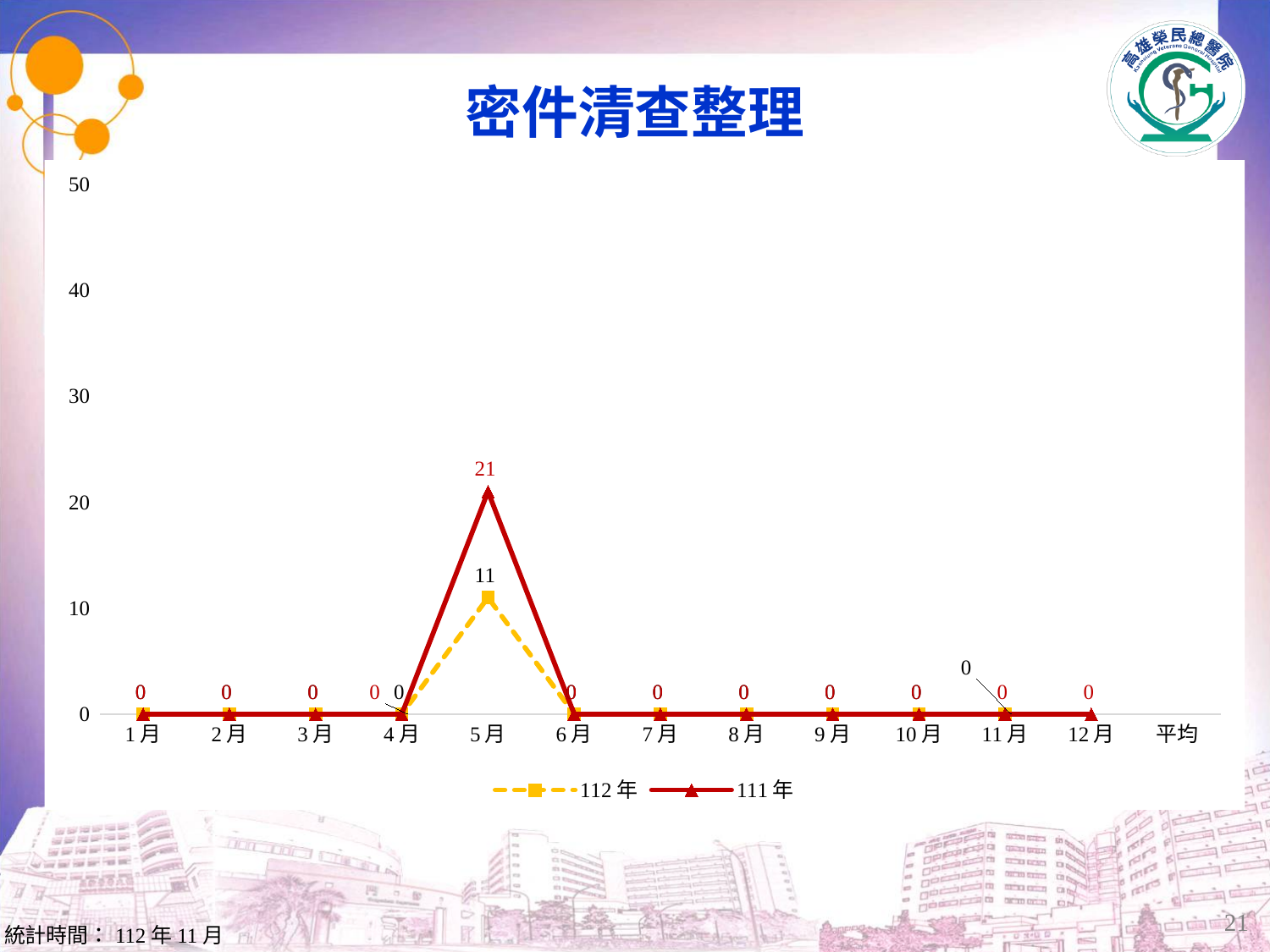
In which month is the value for 111 年 highest? 5月 How many series does the legend list? 2 What kind of chart is shown on the slide? line chart What is the value for 111 年 in 12月? 0 What is the value for 111 年 in 1月? 0 What is the value for 111 年 in 5月? 21 What is the title of the chart? 密件清查整理 What is the value for 112 年 in 5月? 11 What is the difference between the 111 年 and 112 年 values in 5月? 10 Is the value for 111 年 in 5月 greater or less than 20? greater Which series has the larger value in 5月, 111 年 or 112 年? 111 年 In which month is the value for 112 年 highest? 5月